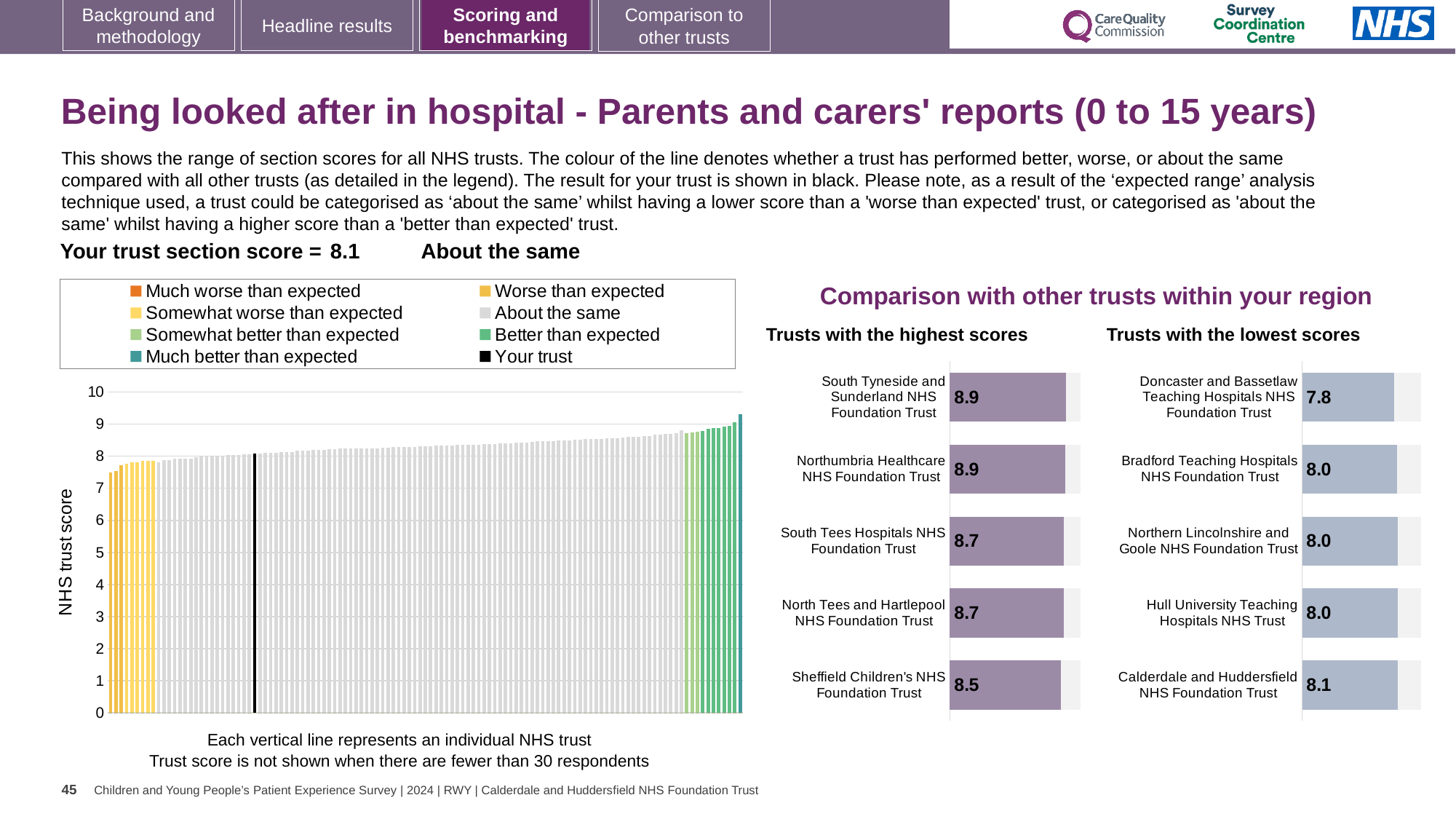
In the 'Trusts with the lowest scores' chart, what is the difference between the score for Calderdale and Huddersfield NHS Foundation Trust and the score for Doncaster and Bassetlaw Teaching Hospitals NHS Foundation Trust? 0.3 In the 'Trusts with the lowest scores' chart, which trust has the lowest score? Doncaster and Bassetlaw Teaching Hospitals NHS Foundation Trust In the 'NHS trust score' chart on the left, do the bars rise or fall from left to right? Rise In the 'Trusts with the highest scores' chart, which trust has the lowest score? Sheffield Children's NHS Foundation Trust In the 'Trusts with the lowest scores' chart, what is the score for Doncaster and Bassetlaw Teaching Hospitals NHS Foundation Trust? 7.8 How many entries does the legend of the 'NHS trust score' chart on the left list? 8 In the 'Trusts with the highest scores' chart, which has the larger score: South Tees Hospitals NHS Foundation Trust or Sheffield Children's NHS Foundation Trust? South Tees Hospitals NHS Foundation Trust In the 'Trusts with the lowest scores' chart, what is the score for Calderdale and Huddersfield NHS Foundation Trust? 8.1 In the 'Trusts with the highest scores' chart, what is the score for Sheffield Children's NHS Foundation Trust? 8.5 How many trusts are shown in the 'Trusts with the lowest scores' chart? 5 In the 'Trusts with the highest scores' chart, what is the difference between the score for South Tyneside and Sunderland NHS Foundation Trust and the score for Sheffield Children's NHS Foundation Trust? 0.4 What kind of chart is the 'NHS trust score' chart on the left of the slide? Bar chart